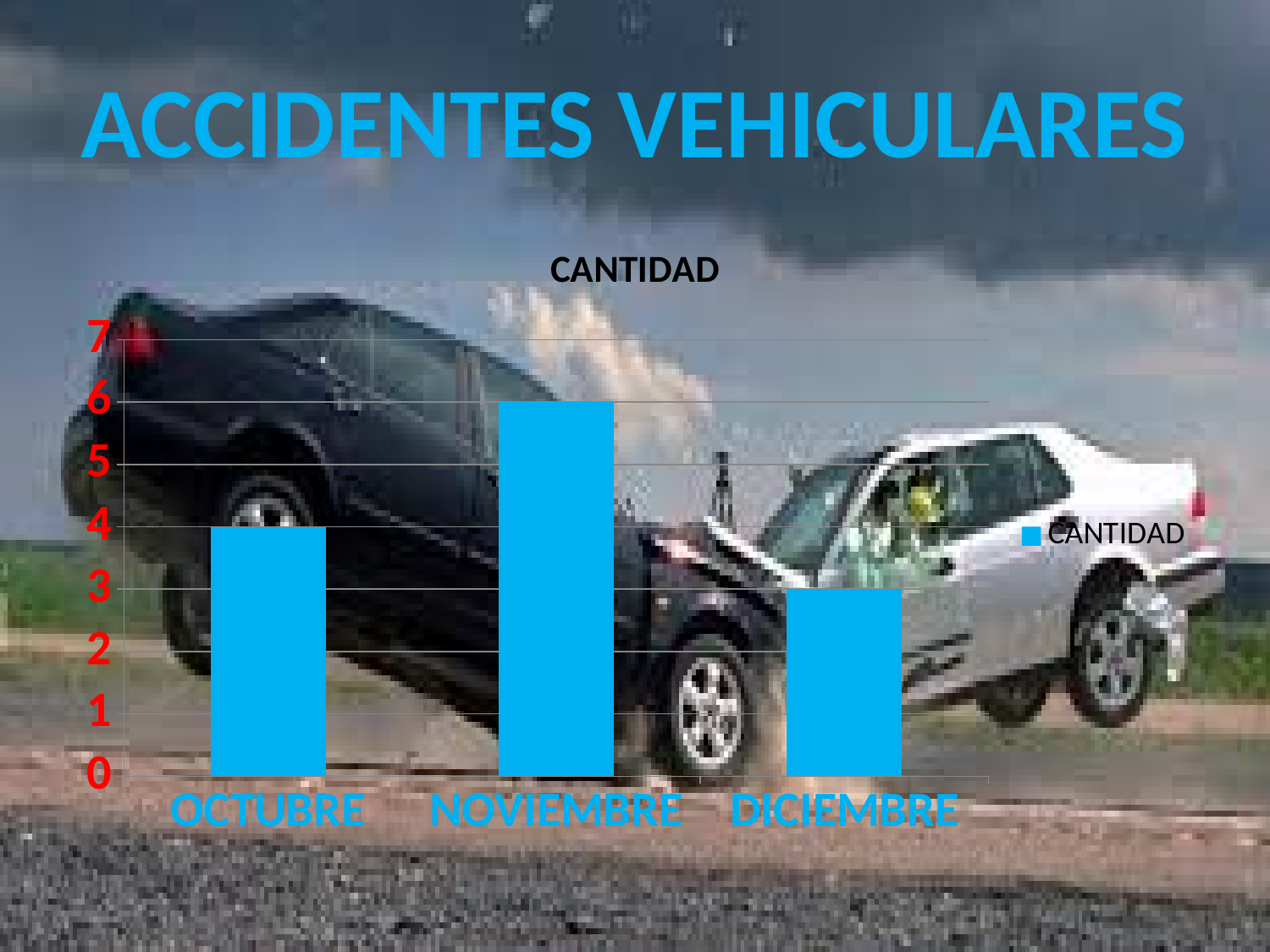
How many series does the legend list? 1 What is the value for NOVIEMBRE? 6 Is the value for NOVIEMBRE greater or less than 5? greater What kind of chart is shown? bar chart Which month has the highest value? NOVIEMBRE What is the title of the chart? CANTIDAD What is the value for OCTUBRE? 4 Which is larger, the value for OCTUBRE or the value for DICIEMBRE? OCTUBRE What is the value for DICIEMBRE? 3 What is the difference between the values for NOVIEMBRE and OCTUBRE? 2 Which month has the lowest value? DICIEMBRE How many months are shown on the x axis? 3